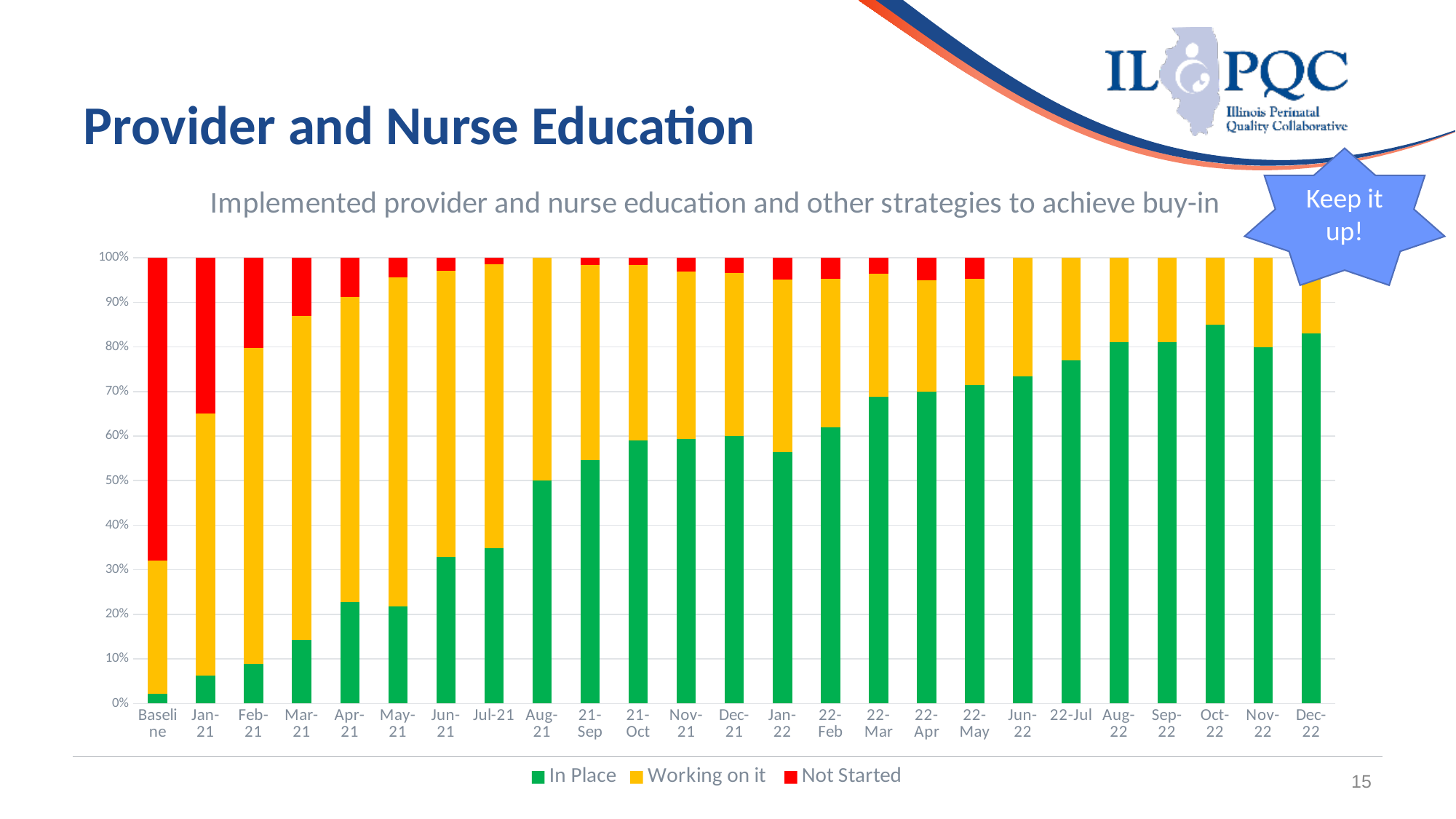
Which category has the highest Not Started value? Baseline Does the In Place share generally rise or fall from Baseline to Dec-22? rise Which category has the lowest In Place value? Baseline What kind of chart is shown on the slide? Stacked bar chart Is the Not Started value for Baseline greater or less than 60%? greater How many categories are shown along the x axis? 25 Is the In Place value for Jun-21 greater or less than 30%? greater How many series does the legend list? 3 Is the In Place value for Dec-22 greater or less than 80%? greater What is the title of the chart? Implemented provider and nurse education and other strategies to achieve buy-in Which is larger, the In Place value for Jan-21 or for Dec-22? Dec-22